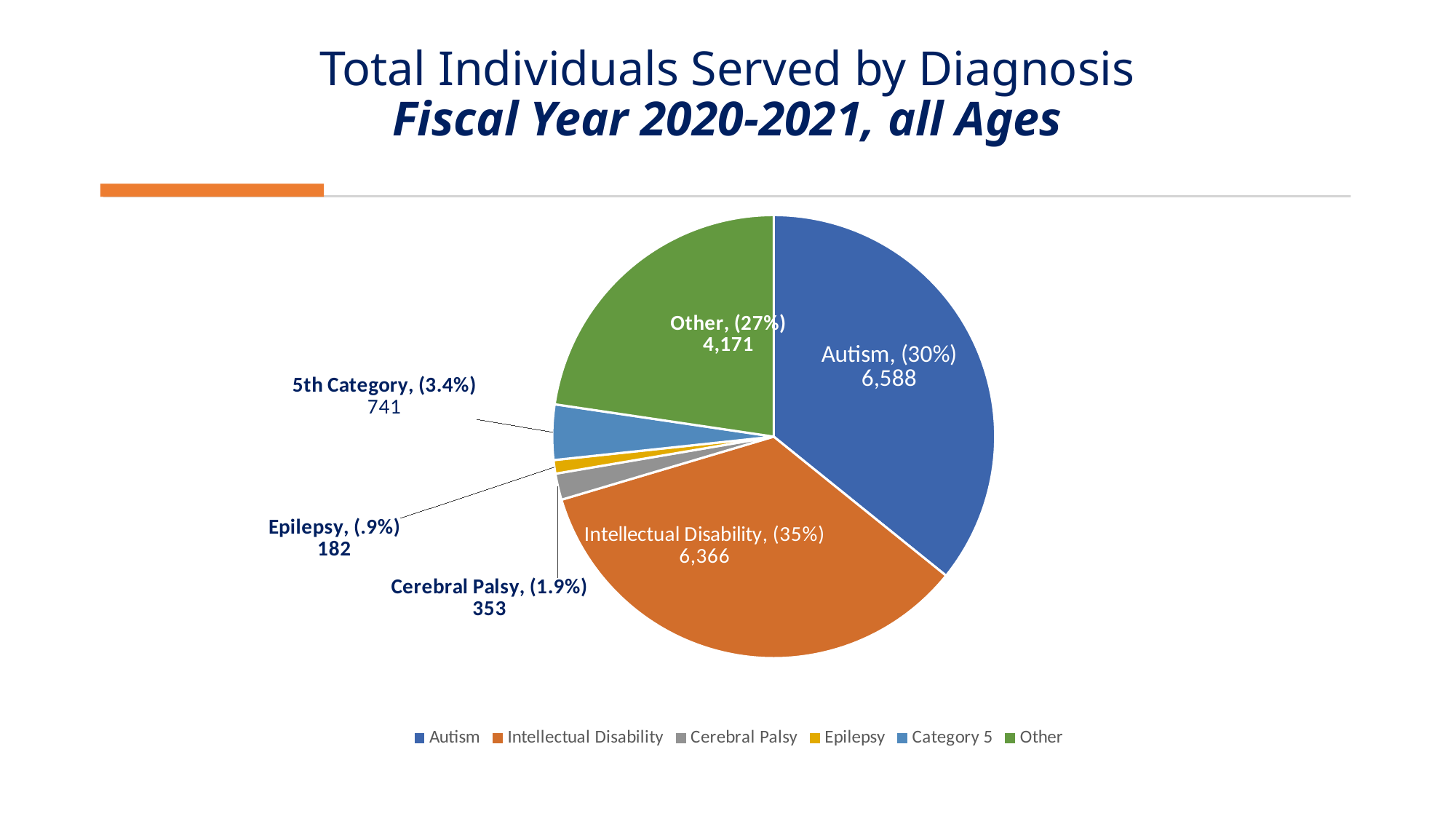
Which diagnosis has the largest percentage share of the pie? Intellectual Disability What percentage of the pie does the Epilepsy slice represent? .9% Which diagnosis has the smallest number of individuals served? Epilepsy How many individuals were served with a diagnosis of Autism? 6,588 How many individuals were served with a diagnosis of Intellectual Disability? 6,366 What is the difference between the number of individuals served for Cerebral Palsy and for Epilepsy? 171 What colour is the Intellectual Disability slice? orange Which has more individuals served, Other or 5th Category? Other What kind of chart is shown on the slide? pie chart How many individuals were served in the 5th Category? 741 What percentage of the pie does the Other slice represent? 27% How many slices does the pie chart have? 6